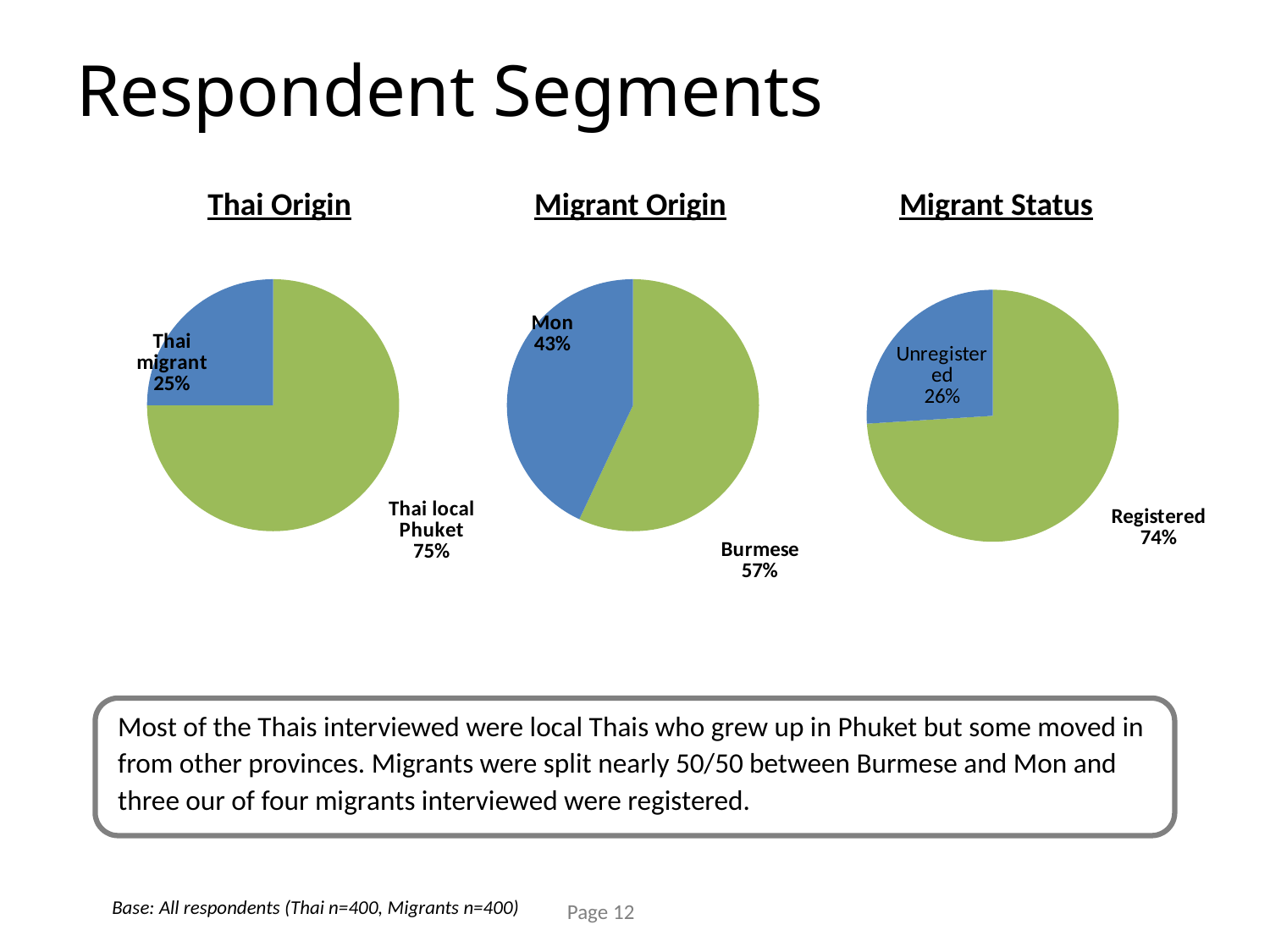
In the Thai Origin chart, what share of respondents are Thai local Phuket? 75% What type of chart is used for Migrant Status? Pie chart In the Migrant Status chart, what share of migrants are Registered? 74% In the Migrant Status chart, what share of migrants are Unregistered? 26% In the Migrant Origin chart, what is the difference in percentage points between Burmese and Mon? 14 In the Migrant Origin chart, what share of respondents are Mon? 43% In the Migrant Status chart, which segment is the smallest? Unregistered In the Thai Origin chart, what share of respondents are Thai migrant? 25% How many slices does the Thai Origin pie chart have? 2 In the Thai Origin chart, which segment is the largest? Thai local Phuket In the Migrant Origin chart, what share of respondents are Burmese? 57% In the Migrant Origin chart, which slice is larger, Burmese or Mon? Burmese